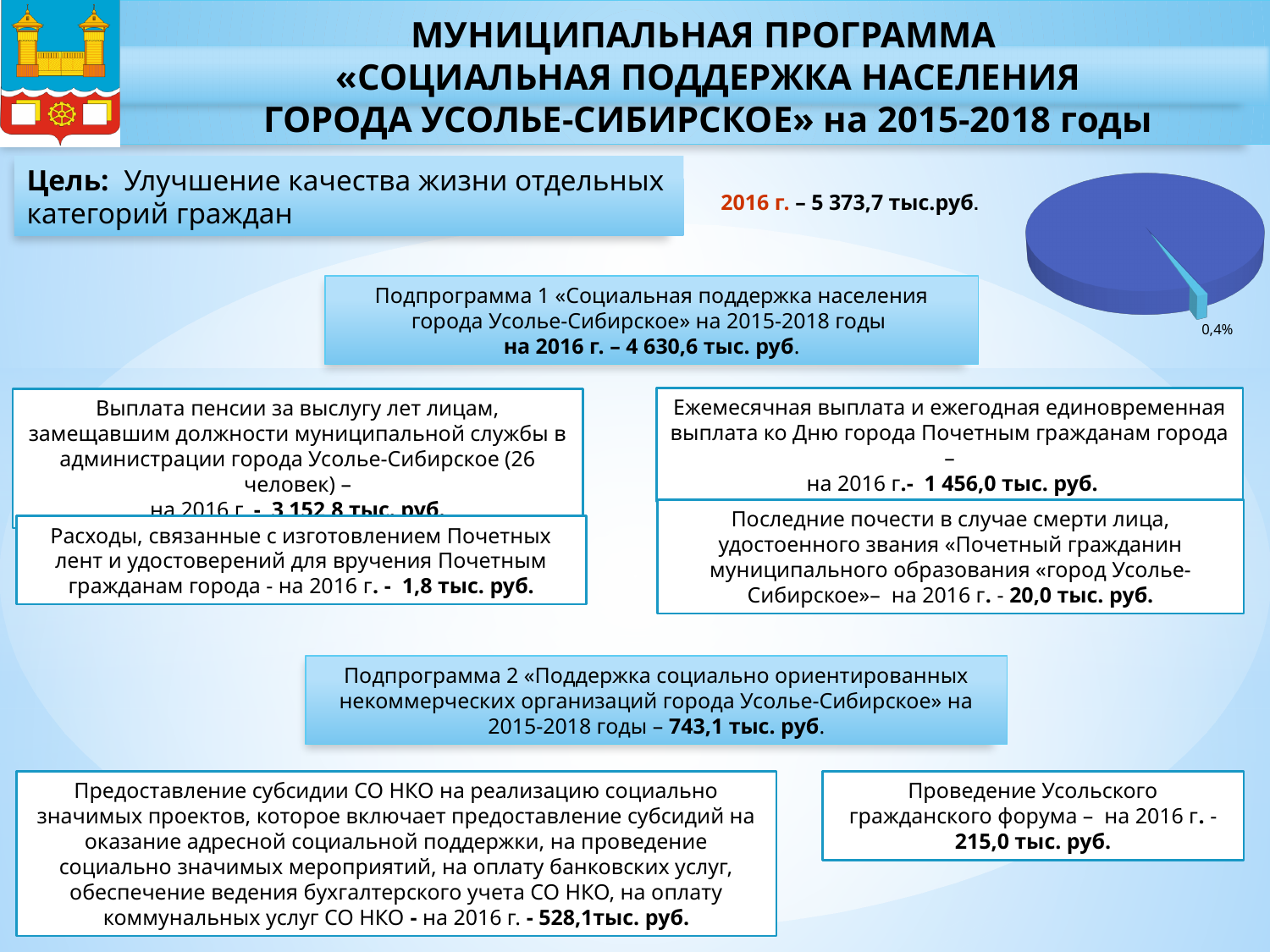
Does the pie chart have a legend? No What share of the pie does the small slice represent? 0,4% What kind of chart is shown in the top-right corner of the slide? pie chart What percentage is printed as the data label on the small slice of the pie chart? 0,4% Is the slice labeled 0,4% larger or smaller than the other slice of the pie chart? smaller What colour is the large slice of the pie chart? blue Is the slice labeled 0,4% the largest or the smallest slice of the pie chart? smallest How many slices does the pie chart have? 2